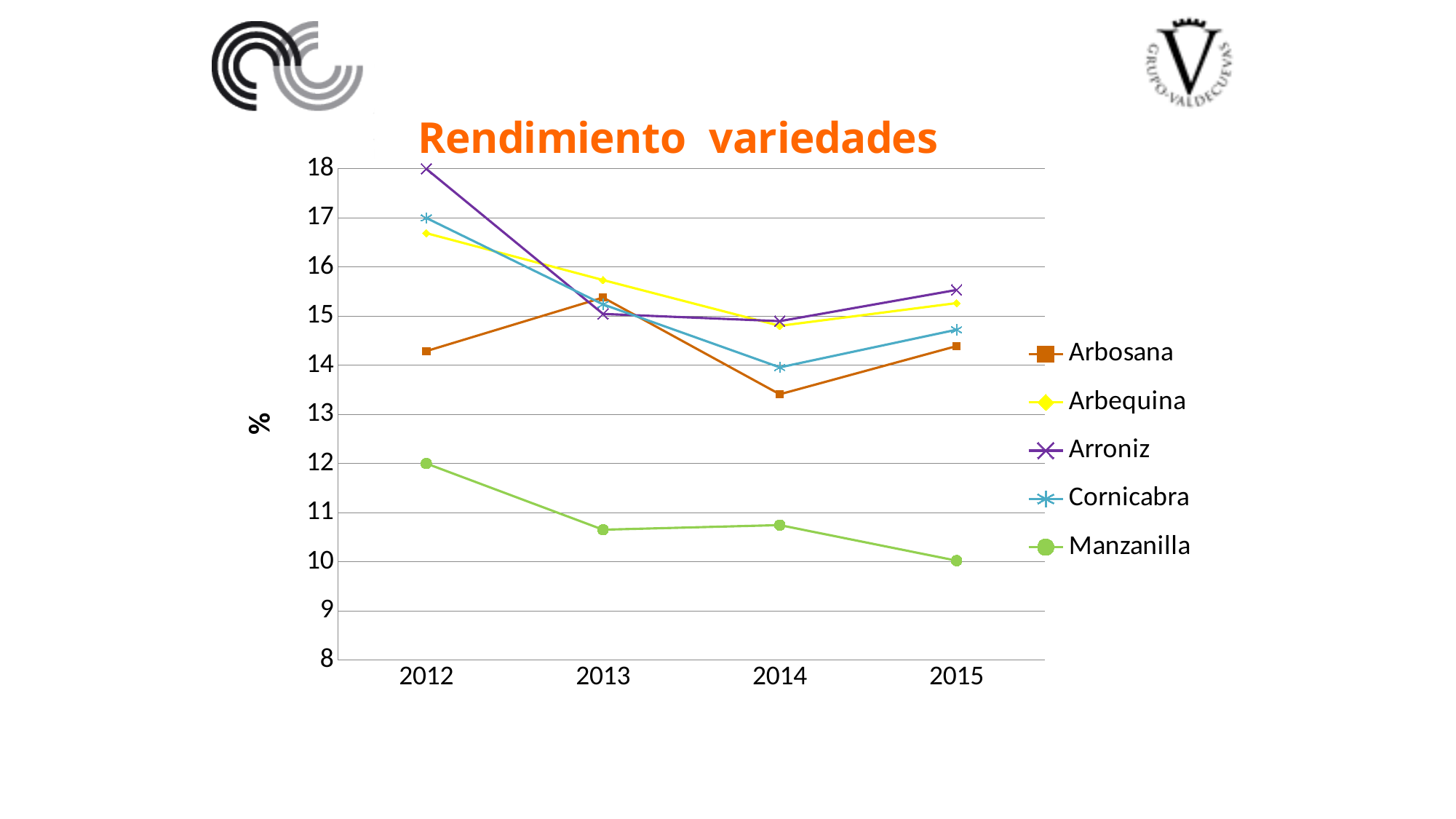
How many years are shown on the x axis? 4 Does the Manzanilla line rise or fall from 2012 to 2015? fall What is the title of the chart? Rendimiento variedades What kind of chart is shown on the slide? line chart Which is larger in 2015, Arroniz or Cornicabra? Arroniz Is the value for Arbequina in 2013 greater or less than 15? greater How many series does the legend list? 5 What is the value for Arroniz in 2012? 18 Which variety has the highest value in 2012? Arroniz Is the value for Arbosana in 2014 greater or less than 14? less What is the value for Manzanilla in 2012? 12 Which variety has the lowest value in 2015? Manzanilla